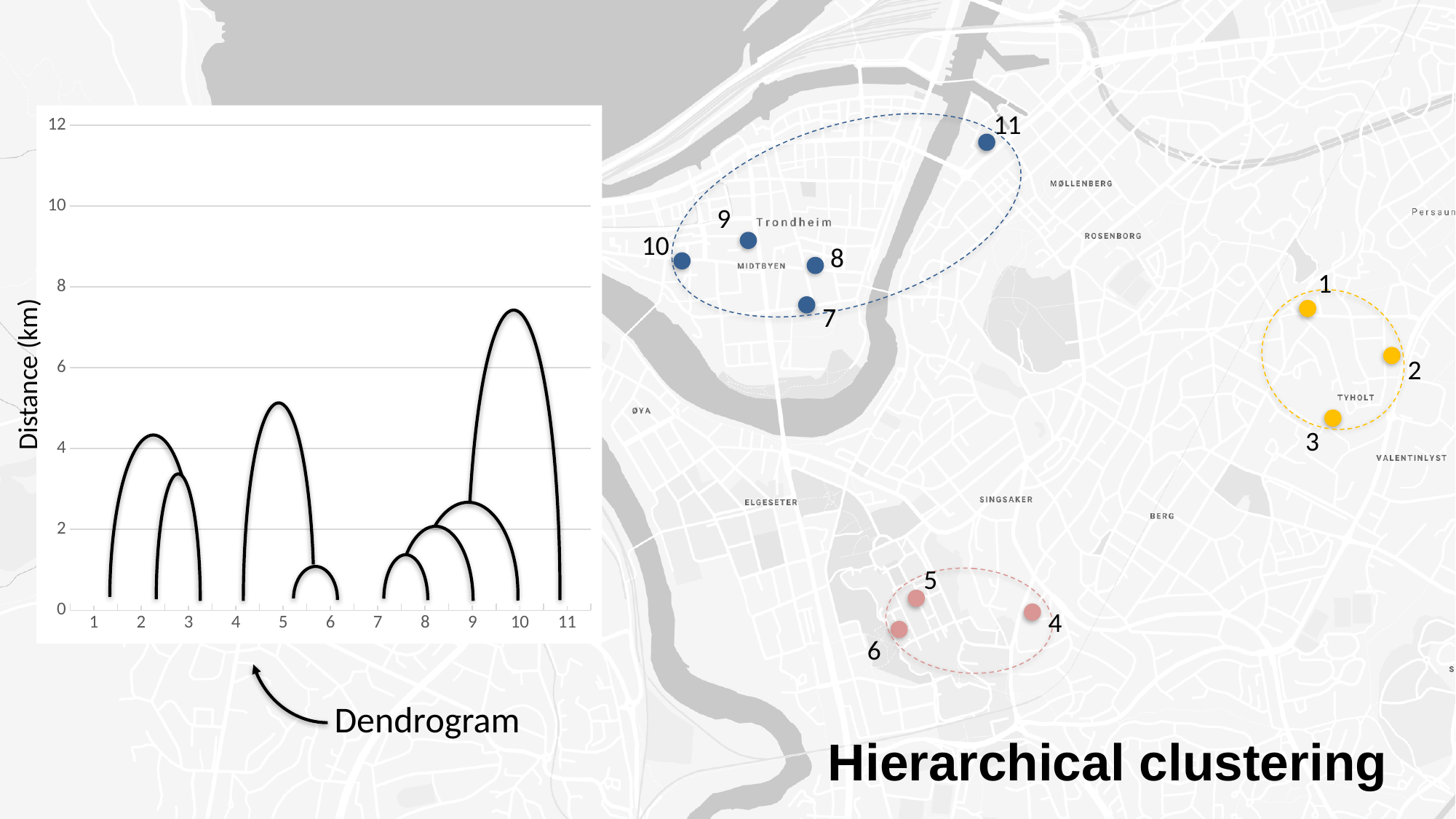
Is the height of the tallest arc in the dendrogram (the one joining point 11) greater or less than 6? greater What kind of chart is shown on the left of the slide? Dendrogram Is the height of the arc joining points 5 and 6 greater or less than 2? less What is the highest tick value shown on the vertical axis of the dendrogram? 12 Is the height of the arc joining point 10 to the 7–8–9 group greater or less than 4? less How many leaf points are labelled along the x axis of the dendrogram? 11 What is the label of the vertical axis of the dendrogram? Distance (km) Which point is joined to the rest of its cluster at the greatest distance in the dendrogram? 11 Which arc is higher: the one joining point 4 to the 5–6 pair, or the one joining point 1 to the 2–3 pair? The arc joining point 4 to the 5–6 pair